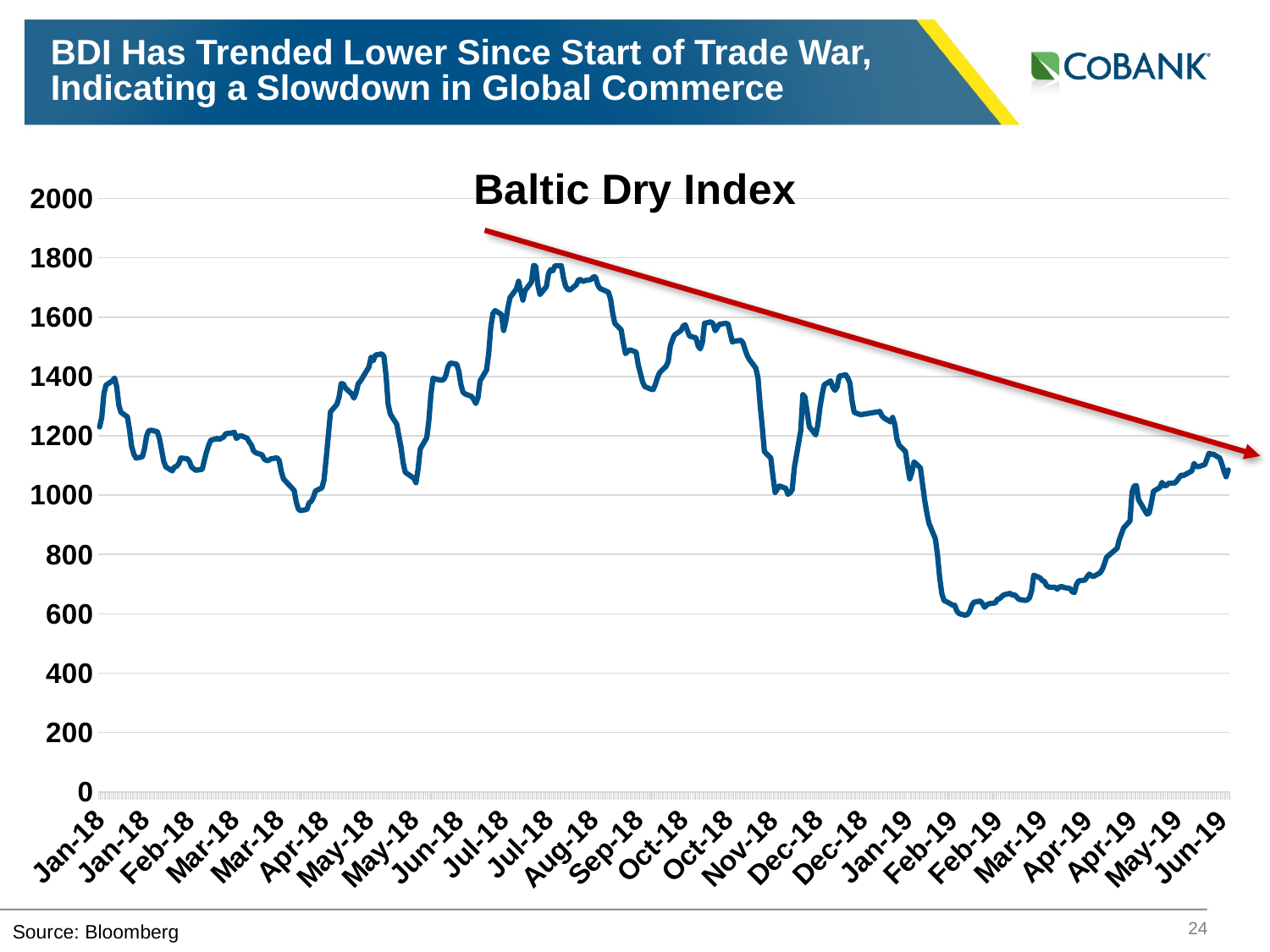
What is the highest value shown on the vertical axis? 2000 Which is higher, the Baltic Dry Index in Oct-18 or in Feb-19? Oct-18 Is the peak value of the Baltic Dry Index in Jul-18 greater or less than 1600? greater What kind of chart is shown on the slide? line chart How many data series are plotted on the chart? 1 According to the red arrow drawn on the chart, is the overall trend of the Baltic Dry Index rising or falling? falling Is the lowest value of the Baltic Dry Index in Feb-19 greater or less than 800? less Is the peak value of the Baltic Dry Index in Jul-18 greater or less than 1800? less In which month does the Baltic Dry Index reach its lowest point on the chart? Feb-19 What is the title of the chart? Baltic Dry Index